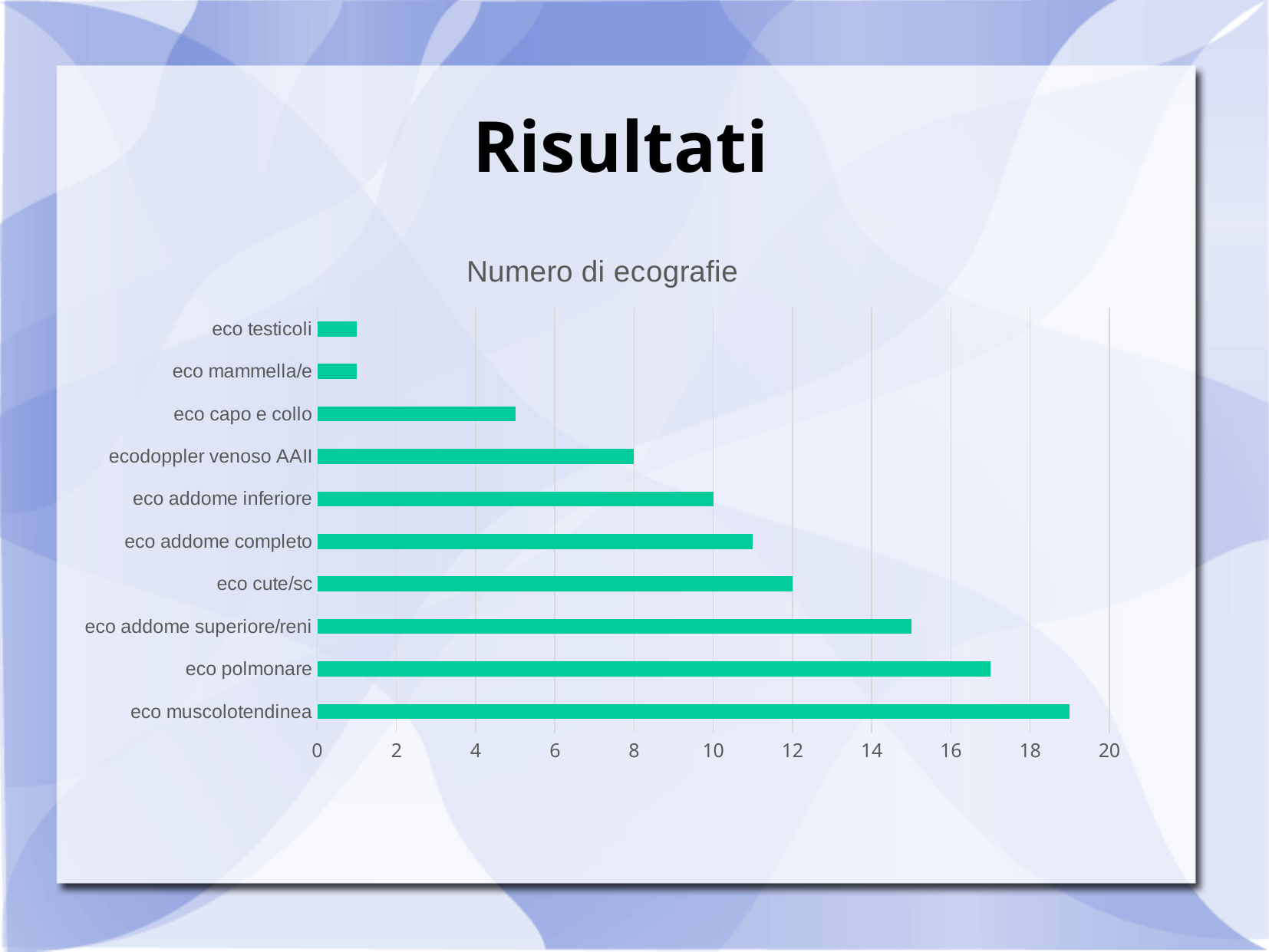
What is the value for eco cute/sc? 12 What type of chart is shown on the slide? bar chart Is the value for eco testicoli greater or less than 2? less What is the value for ecodoppler venoso AAII? 8 How many categories are plotted in the chart? 10 What is the value for eco addome inferiore? 10 Which category has the highest value? eco muscolotendinea Is the value for eco muscolotendinea greater or less than 18? greater What is the title of the chart? Numero di ecografie What is the difference between the values for eco cute/sc and ecodoppler venoso AAII? 4 Is the value for eco capo e collo greater or less than 6? less Which is larger, the value for eco polmonare or the value for eco addome superiore/reni? eco polmonare